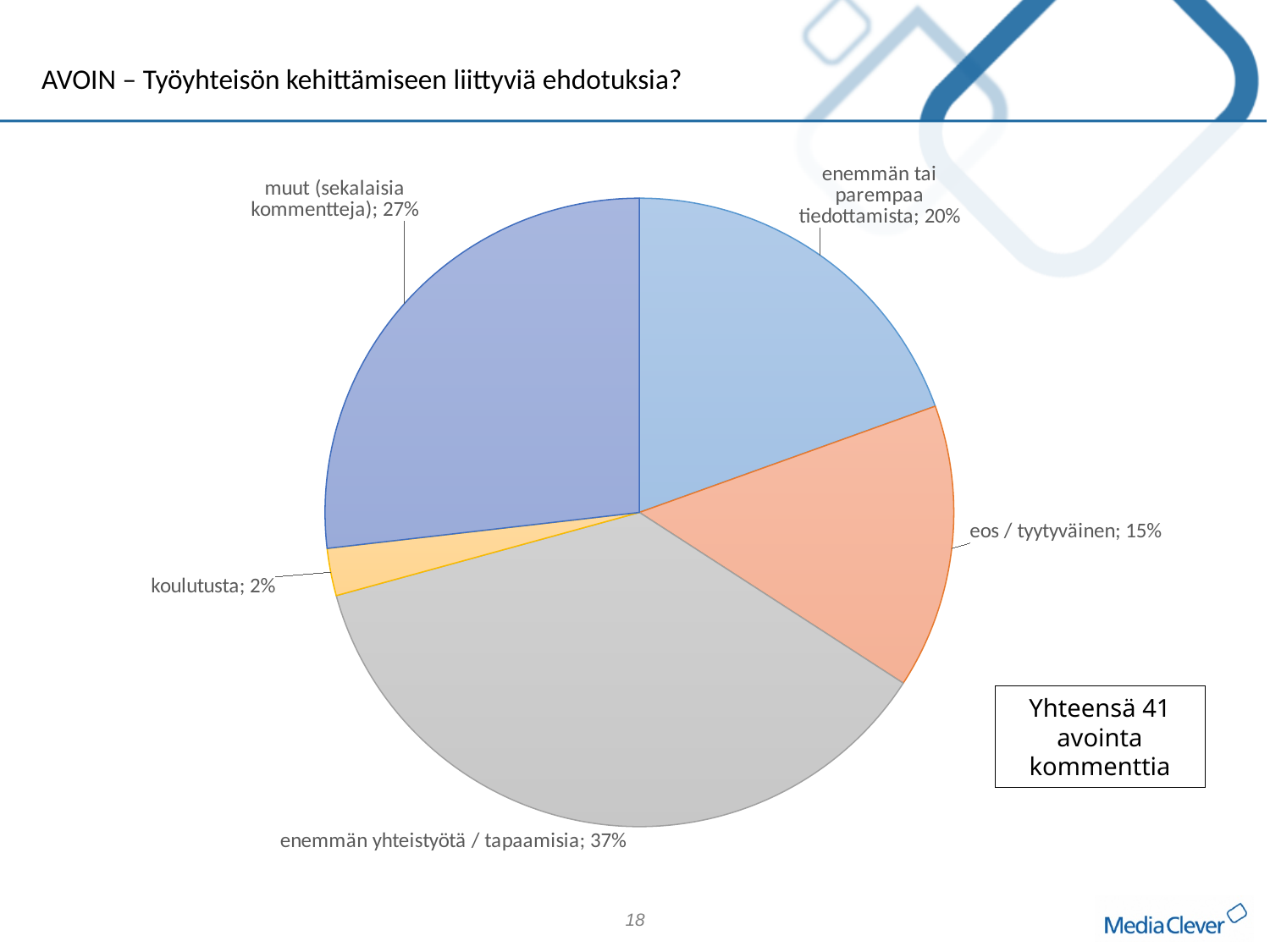
How many slices does the pie chart have? 5 Which is larger, "enemmän tai parempaa tiedottamista" or "eos / tyytyväinen"? enemmän tai parempaa tiedottamista Which category has the largest slice of the pie? enemmän yhteistyötä / tapaamisia According to the text box on the slide, how many open comments were there in total? 41 What is the difference in percentage points between "enemmän yhteistyötä / tapaamisia" and "muut (sekalaisia kommentteja)"? 10 What is the value shown for "muut (sekalaisia kommentteja)"? 27% What is the value shown for "enemmän tai parempaa tiedottamista"? 20% What share of the pie does "enemmän yhteistyötä / tapaamisia" have? 37% Which category has the smallest slice of the pie? koulutusta What is the value shown for "koulutusta"? 2% What is the value shown for "eos / tyytyväinen"? 15% What kind of chart is shown on the slide? pie chart